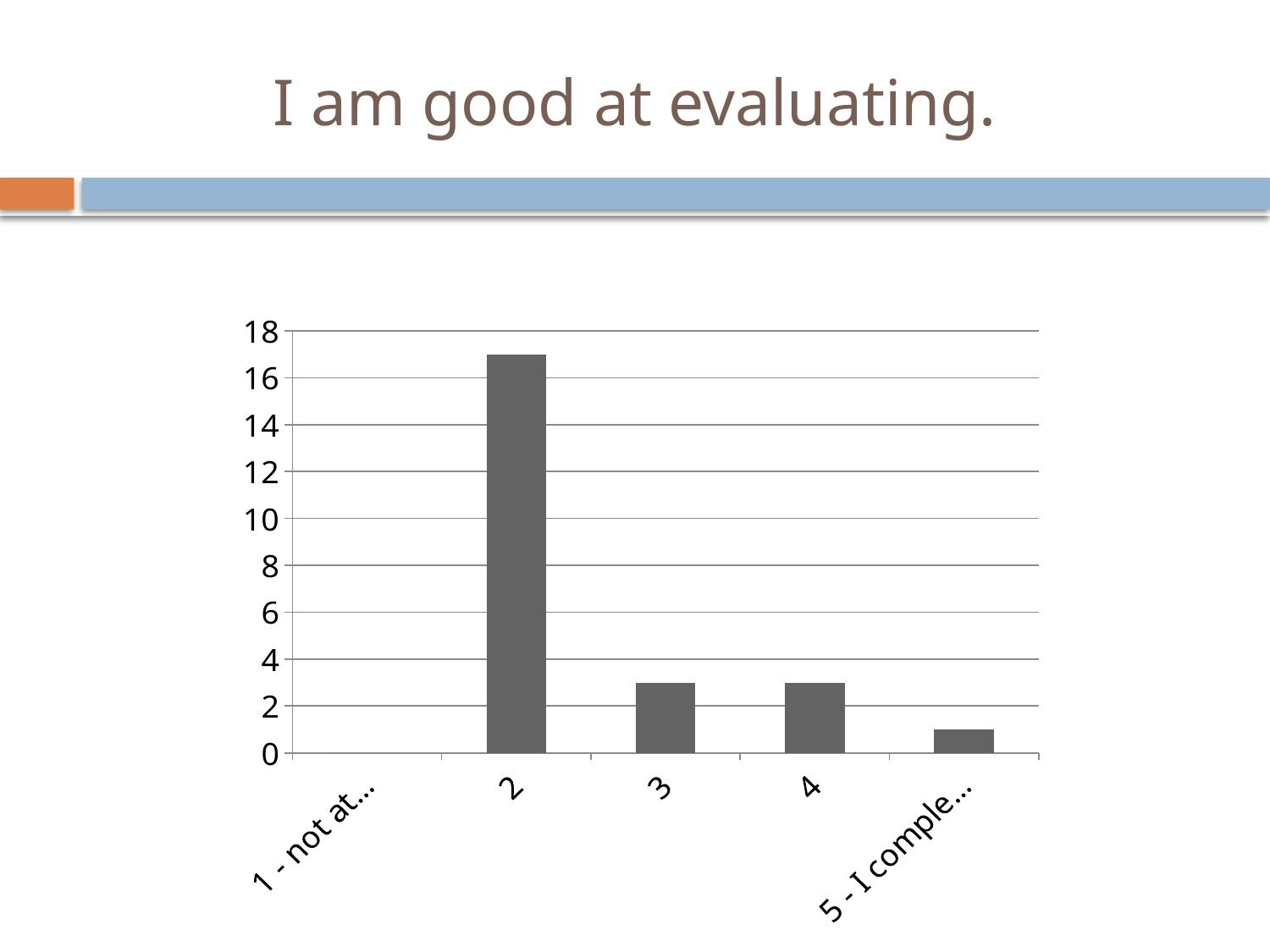
What kind of chart is shown on the slide? bar chart Which category has the highest value? 2 From category 2 to category 5 - I comple..., do the values rise or fall? fall Is the value for category 5 - I comple... greater or less than 2? less What is the title of the slide? I am good at evaluating. Which category has the lowest value? 1 - not at... Which is larger, the value for category 4 or the value for category 5 - I comple...? 4 How many categories are shown on the x axis? 5 Is the value for category 4 greater or less than 2? greater Which is larger, the value for category 2 or the value for category 3? 2 Is the value for category 2 greater or less than 16? greater